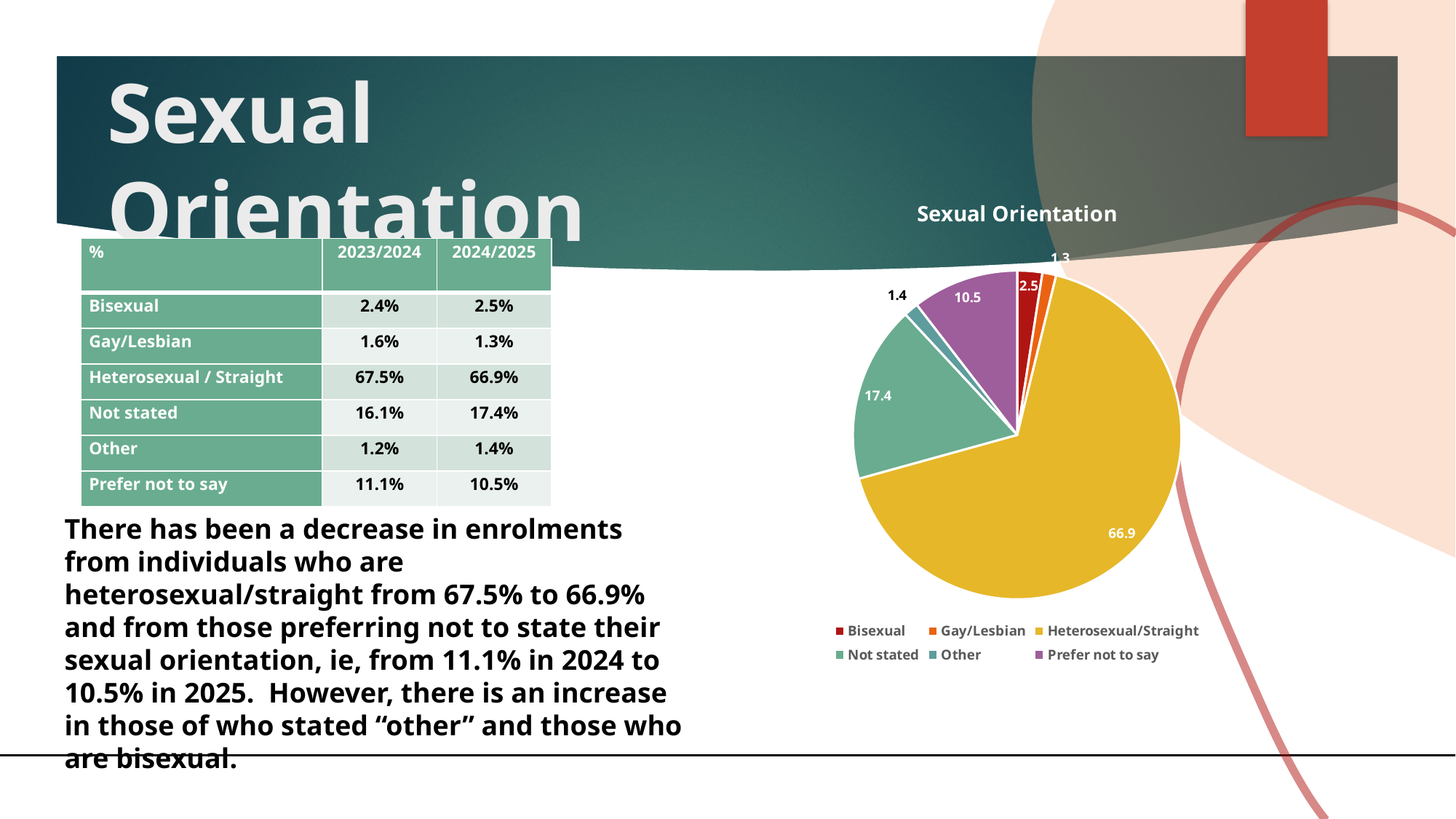
What type of chart is shown on the slide? Pie chart What is the value shown for Other in the pie chart? 1.4 What is the value shown for Not stated in the pie chart? 17.4 Which category has the smallest slice in the pie chart? Gay/Lesbian What is the value shown for Prefer not to say in the pie chart? 10.5 Which category has the largest slice in the pie chart? Heterosexual/Straight What is the difference between the Not stated and Prefer not to say values in the pie chart? 6.9 How many categories does the legend of the pie chart list? 6 What is the value shown for Bisexual in the pie chart? 2.5 What is the title of the chart? Sexual Orientation Which is larger in the pie chart, Not stated or Prefer not to say? Not stated What is the value shown for Heterosexual/Straight in the pie chart? 66.9